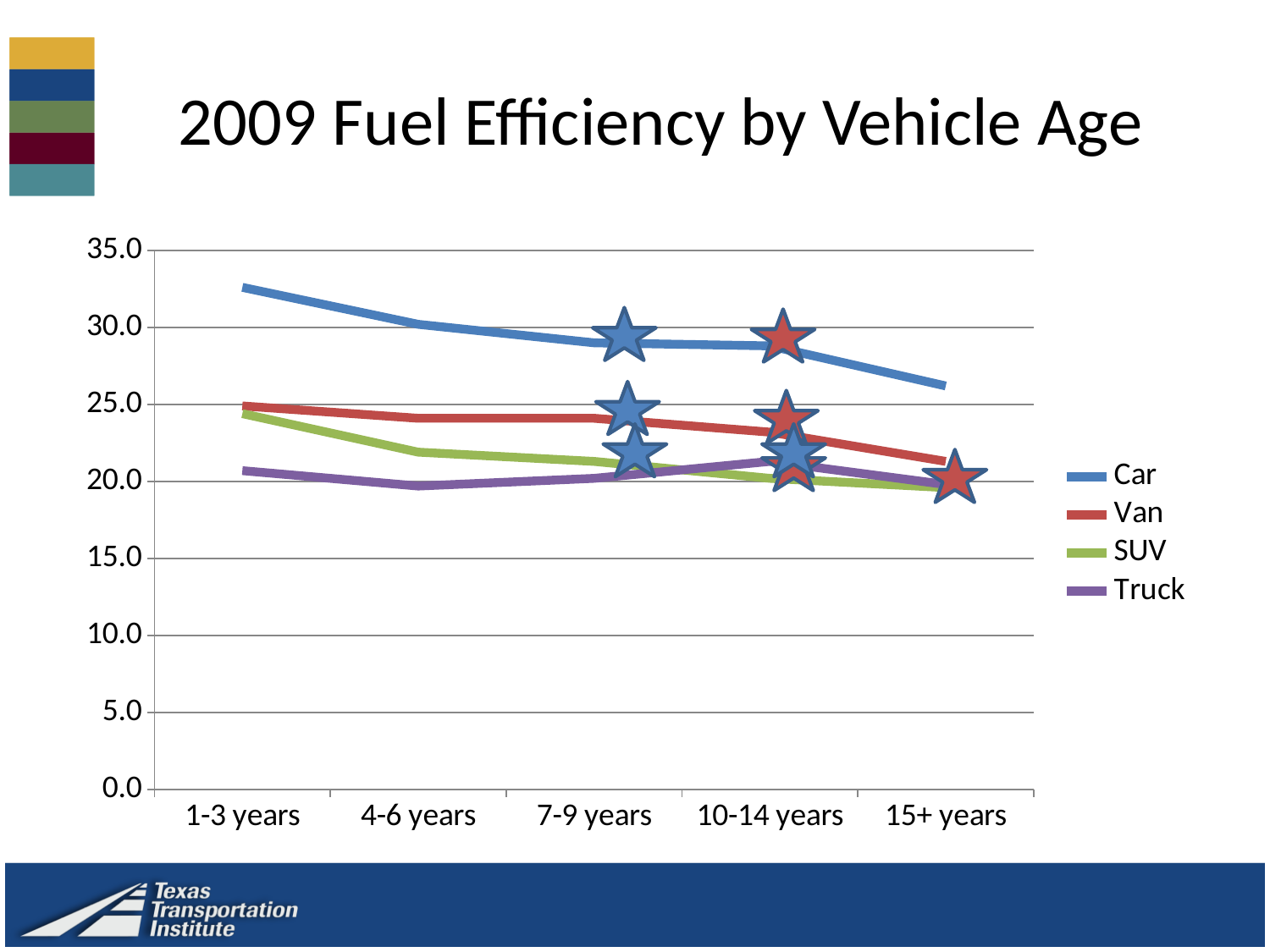
Which series has the lowest value at 4-6 years? Truck Which is larger at 4-6 years, Van or SUV? Van How many vehicle age categories are shown on the x axis? 5 Is the value for SUV at 4-6 years greater or less than 20.0? greater Which series has the lowest value at 1-3 years? Truck How many series does the legend list? 4 Is the value for Car at 1-3 years greater or less than 30.0? greater Is the value for Car at 7-9 years greater or less than 30.0? less What kind of chart is shown on the slide? line chart Does the Car series rise or fall as vehicle age increases along the x axis? fall What is the title of the chart? 2009 Fuel Efficiency by Vehicle Age Which series has the highest value at 1-3 years? Car